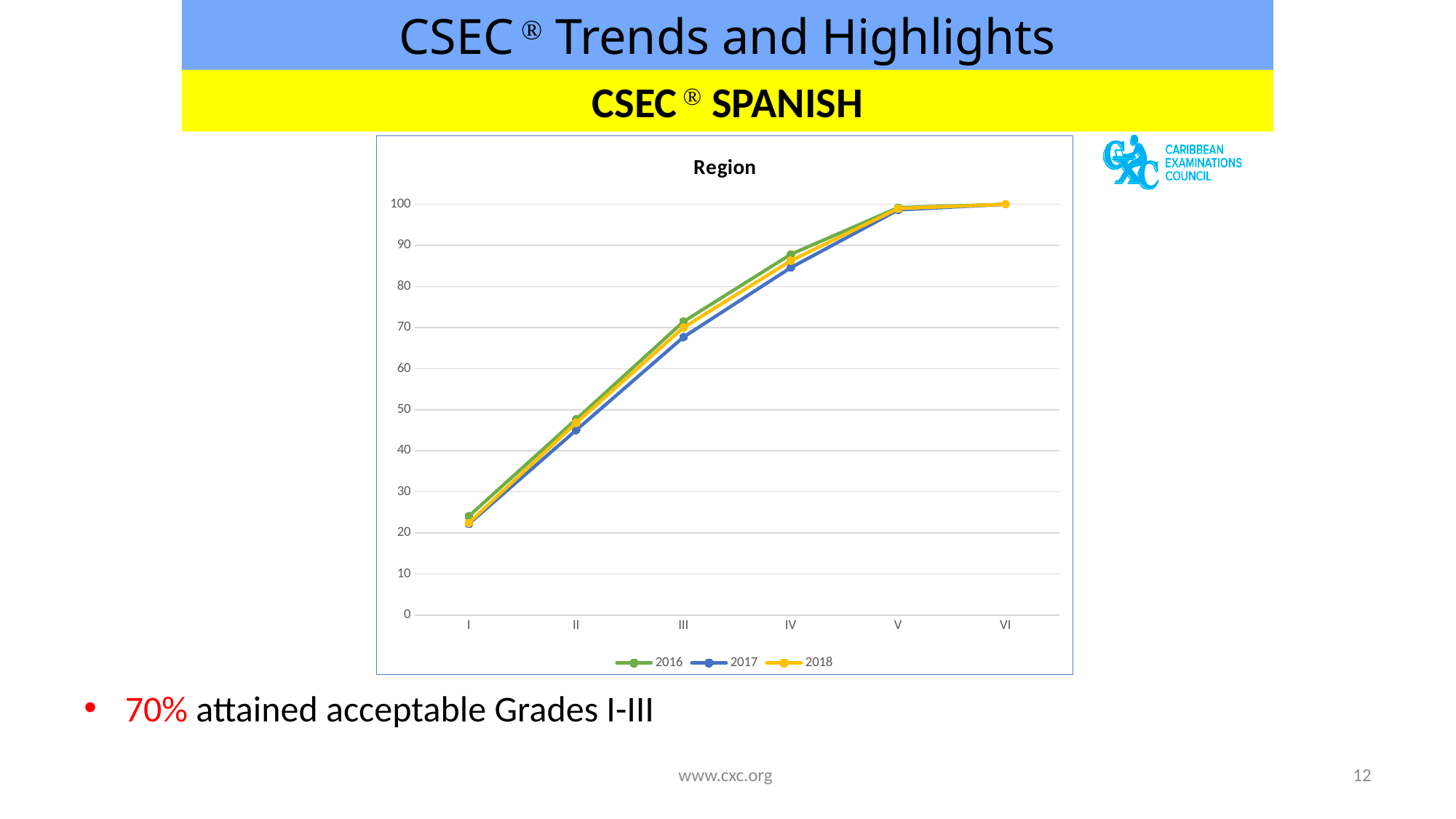
Is the 2017 value at Grade II greater or less than 50? less What kind of chart is shown on the slide? line chart What value do all three series reach at Grade VI? 100 Is the 2018 value at Grade IV greater or less than 80? greater What is the title of the chart? Region Do the values rise or fall from Grade I to Grade VI? rise Which years are listed in the chart legend? 2016, 2017, 2018 How many series does the legend list? 3 At Grade III, which series has the higher value, 2016 or 2017? 2016 How many grade categories are shown on the x axis? 6 Is the 2017 value at Grade I greater or less than 30? less